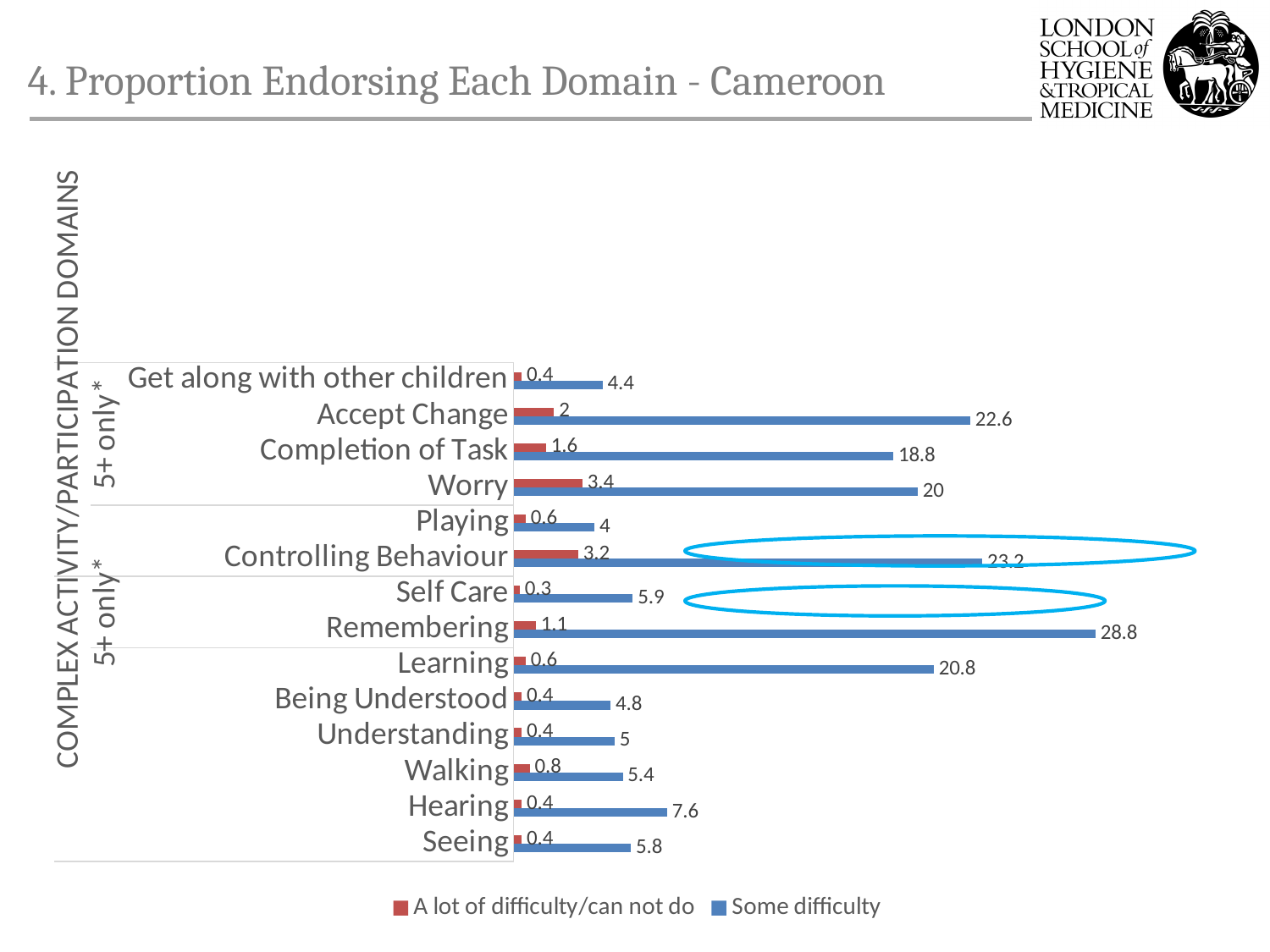
Which colour represents the 'Some difficulty' series? Blue Which has a larger 'Some difficulty' value, Controlling Behaviour or Learning? Controlling Behaviour What is the 'Some difficulty' value for Remembering? 28.8 What is the 'Some difficulty' value for Playing? 4 What is the 'A lot of difficulty/can not do' value for Worry? 3.4 What is the 'Some difficulty' value for Hearing? 7.6 Which domain has the lowest 'A lot of difficulty/can not do' value? Self Care How many series does the legend list? 2 Which domain has the highest 'Some difficulty' value? Remembering What is the difference between the 'Some difficulty' values for Accept Change and Completion of Task? 3.8 How many domains are shown in the chart? 14 What kind of chart is shown on the slide? Bar chart